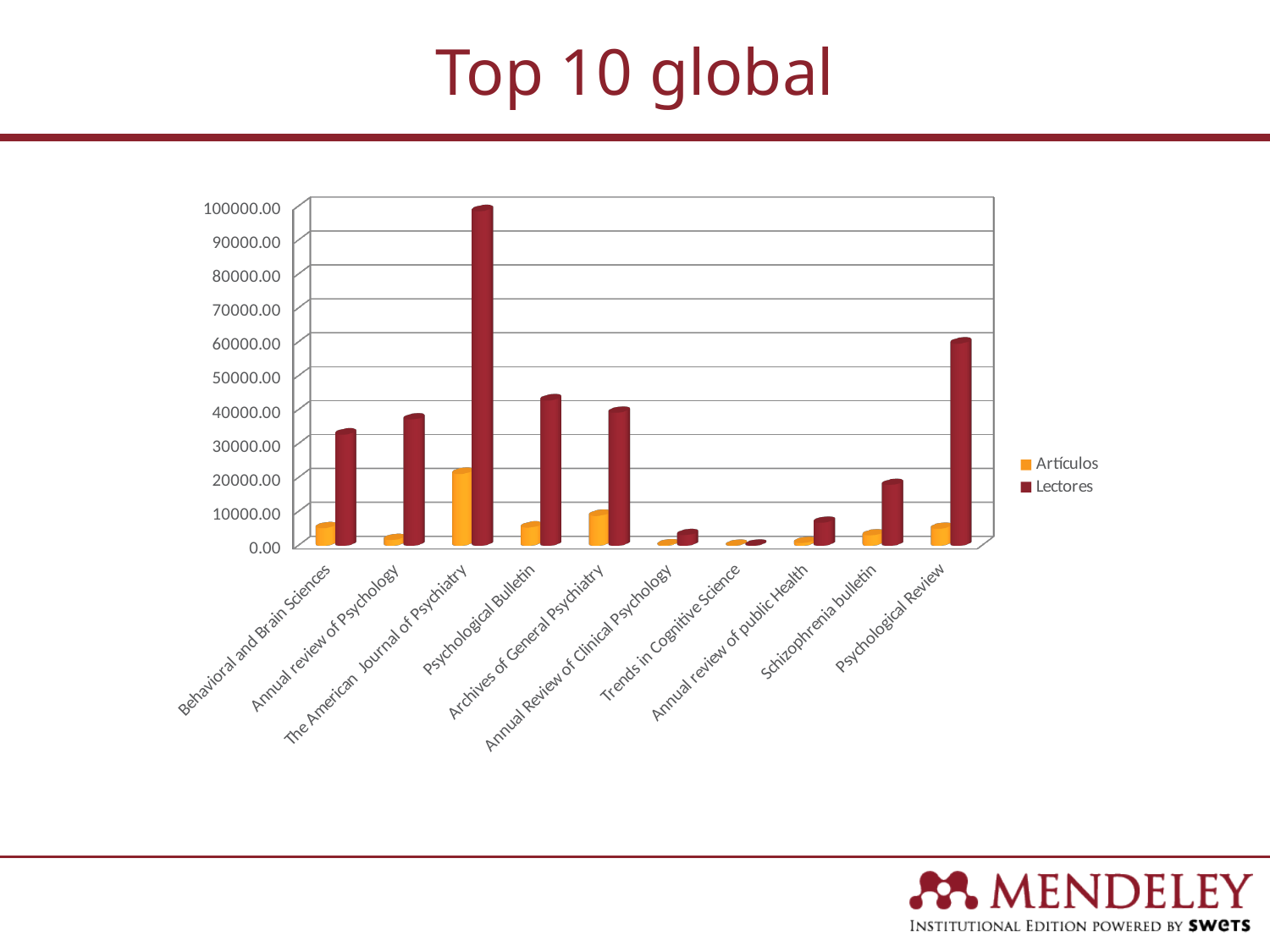
What kind of chart is shown on the slide? bar chart Is the Lectores value for The American Journal of Psychiatry greater or less than 90000.00? greater Which journal has the highest Lectores value? The American Journal of Psychiatry Is the Lectores value for Psychological Review greater or less than 50000.00? greater How many series does the legend list? 2 Which has the larger Lectores value, Psychological Review or Psychological Bulletin? Psychological Review Which journal has the lowest Lectores value? Trends in Cognitive Science Is the Lectores value for Schizophrenia bulletin greater or less than 30000.00? less Which journal has the highest Artículos value? The American Journal of Psychiatry What is the title of the slide containing the chart? Top 10 global How many journals (categories) are shown on the x axis? 10